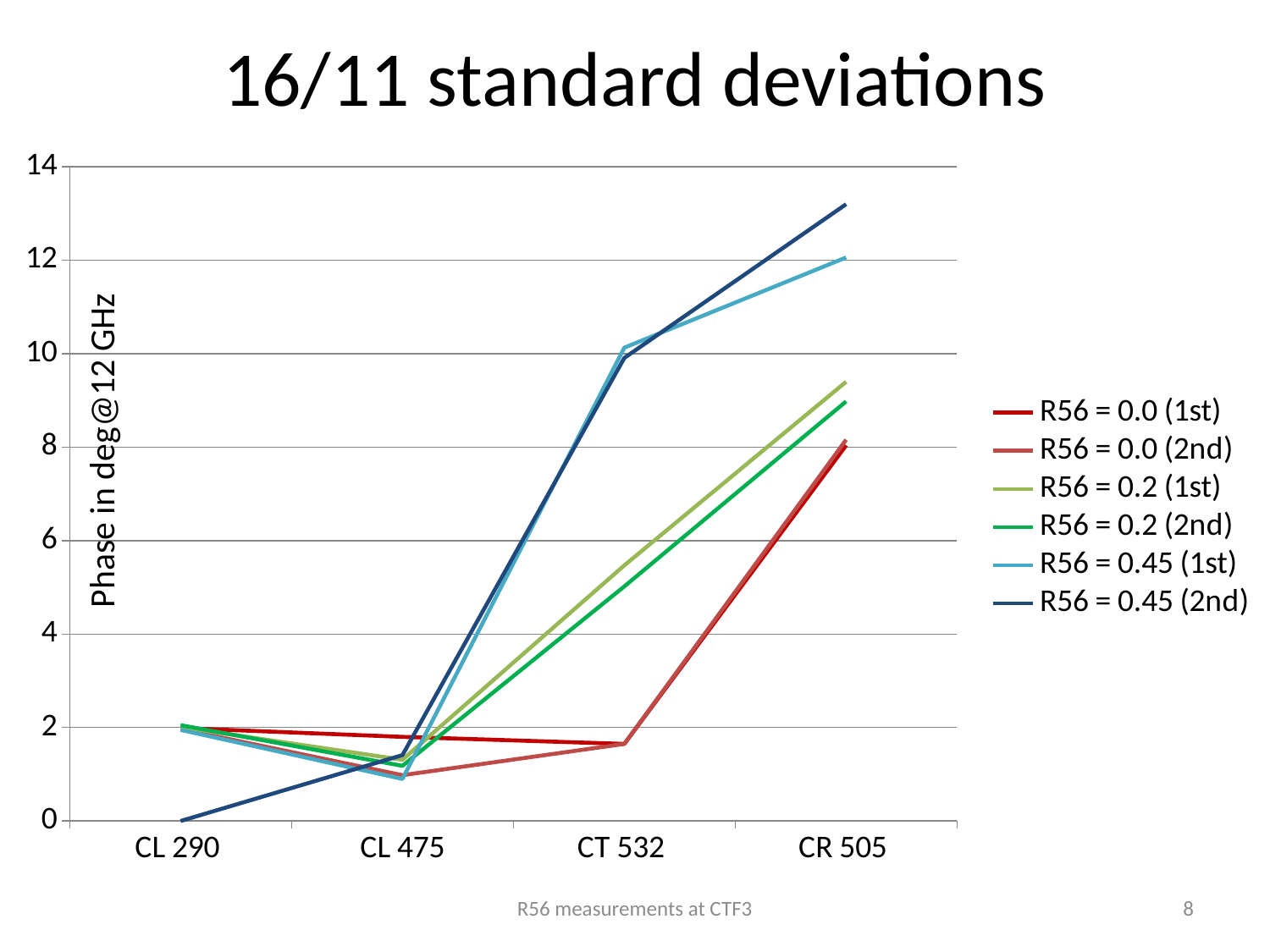
What is the value of R56 = 0.45 (2nd) at CL 290? 0 Is the value for R56 = 0.2 (1st) at CR 505 greater or less than 10? less At CT 532, which is larger: R56 = 0.45 (1st) or R56 = 0.2 (1st)? R56 = 0.45 (1st) What kind of chart is shown on the slide? line chart Which series has the lowest value at CL 290? R56 = 0.45 (2nd) How many categories are shown on the x axis? 4 Which series has the highest value at CR 505? R56 = 0.45 (2nd) Is the value for R56 = 0.0 (2nd) at CT 532 greater or less than 2? less Does the R56 = 0.45 (2nd) series rise or fall from CL 290 to CR 505? rise Is the value for R56 = 0.45 (2nd) at CR 505 greater or less than 12? greater What is the label of the y axis? Phase in deg@12 GHz How many series does the legend list? 6